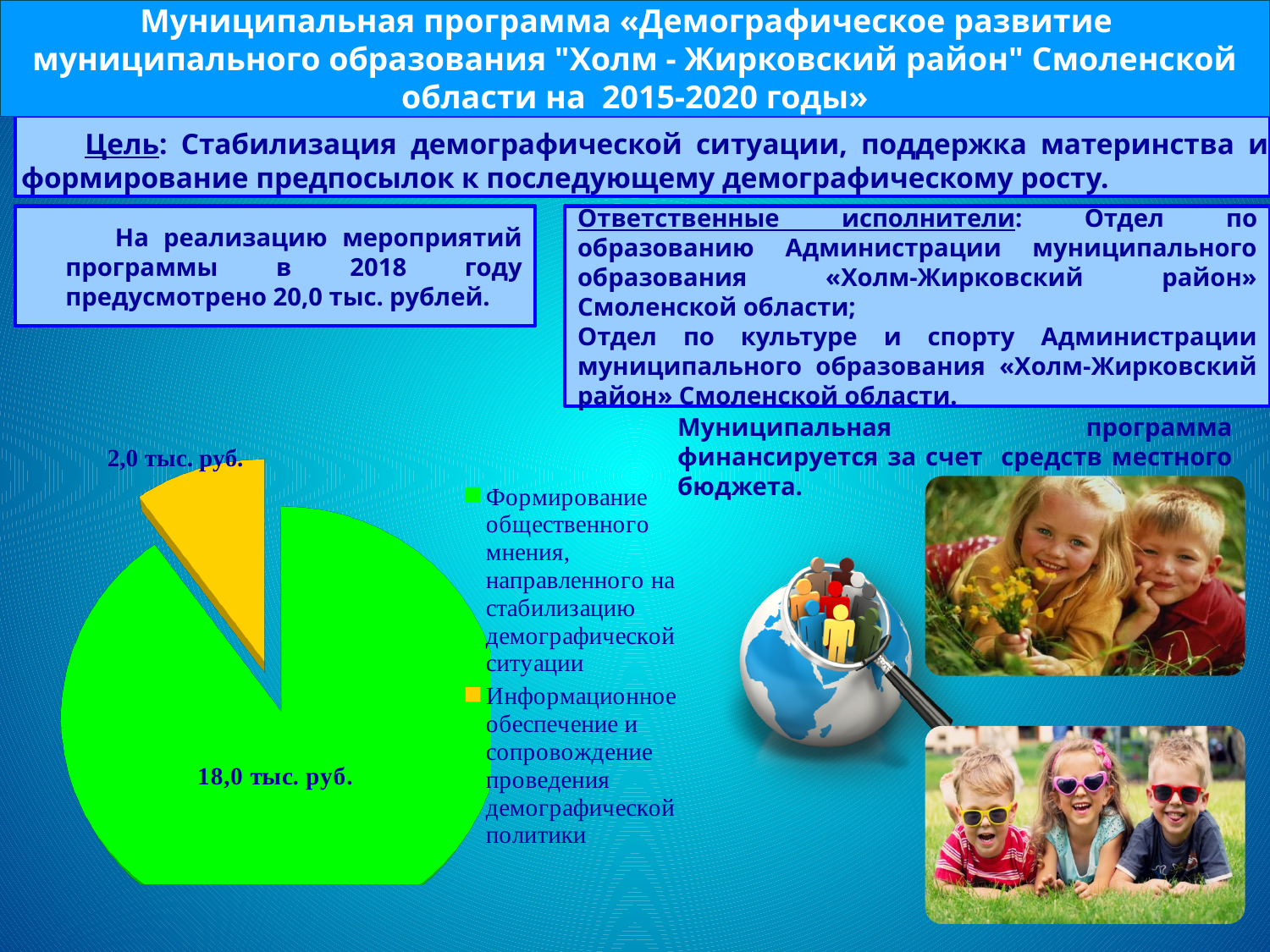
How many entries does the legend of the pie chart list? 2 What is the difference between the two slices of the pie chart, in тыс. руб.? 16,0 тыс. руб. What kind of chart is shown on the slide? pie chart How many slices does the pie chart have? 2 What is the value of the slice for «Информационное обеспечение и сопровождение проведения демографической политики»? 2,0 тыс. руб. What is the value of the slice for «Формирование общественного мнения, направленного на стабилизацию демографической ситуации»? 18,0 тыс. руб. What is the total of the two slices in the pie chart? 20,0 тыс. руб. What share of the pie does the slice «Формирование общественного мнения...» represent? 90% Which slice of the pie chart is the smallest? Информационное обеспечение и сопровождение проведения демографической политики Which slice of the pie chart is the largest? Формирование общественного мнения, направленного на стабилизацию демографической ситуации Which is larger: the slice for «Формирование общественного мнения...» or the slice for «Информационное обеспечение...»? Формирование общественного мнения, направленного на стабилизацию демографической ситуации What colour is the slice for «Информационное обеспечение и сопровождение проведения демографической политики»? yellow